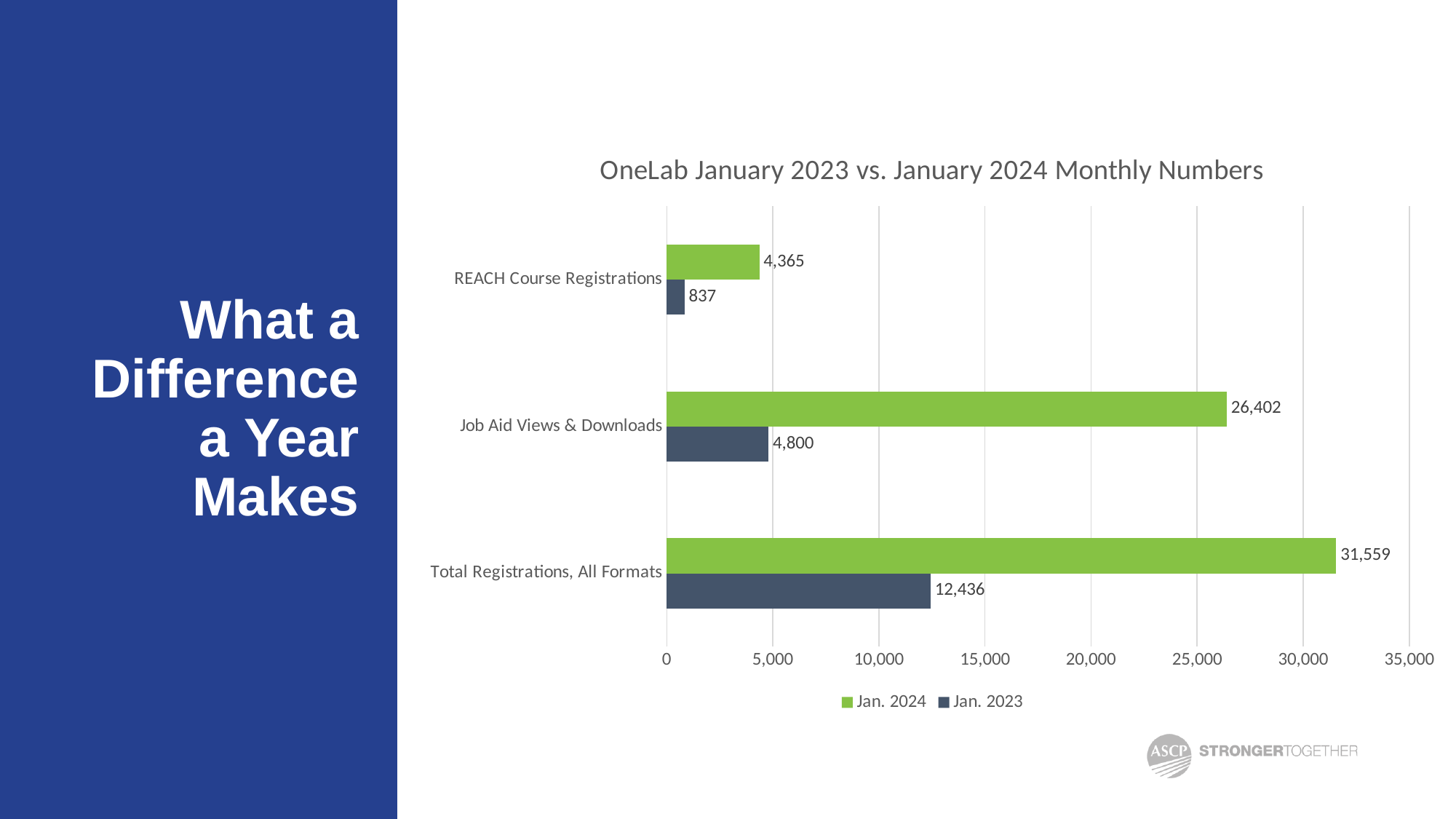
Which category has the lowest Jan. 2023 value? REACH Course Registrations What is the Jan. 2023 value for Total Registrations, All Formats? 12,436 Which category has the highest Jan. 2024 value? Total Registrations, All Formats How many categories are shown on the chart? 3 Is the Jan. 2024 value for Total Registrations, All Formats greater or less than 30,000? greater What is the Jan. 2023 value for Job Aid Views & Downloads? 4,800 How many series does the legend list? 2 What is the Jan. 2024 value for REACH Course Registrations? 4,365 What is the difference between the Jan. 2024 and Jan. 2023 values for Job Aid Views & Downloads? 21,602 What is the difference between the Jan. 2024 and Jan. 2023 values for Total Registrations, All Formats? 19,123 Which is larger: the Jan. 2023 value for Job Aid Views & Downloads or the Jan. 2024 value for REACH Course Registrations? Jan. 2023 value for Job Aid Views & Downloads What type of chart is shown on the slide? Bar chart